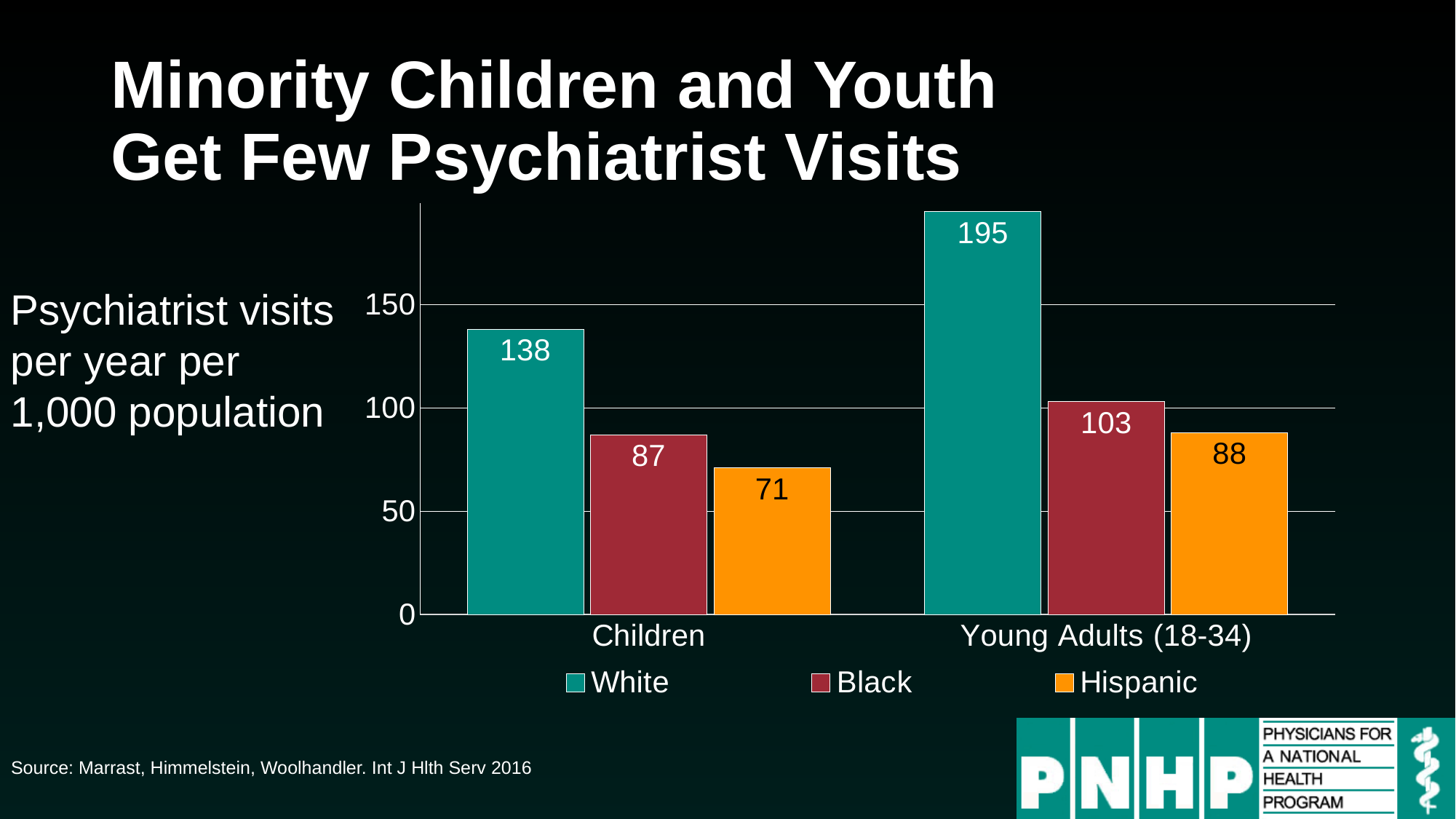
What is the difference between the White values for Young Adults (18-34) and Children? 57 Which series has the highest value in the Young Adults (18-34) category? White What is the value for Black in the Children category? 87 How many series does the legend list? 3 Is the value for Black in the Young Adults (18-34) category greater or less than 100? greater What is the difference between the White and Black values for Young Adults (18-34)? 92 Which series has the lowest value in the Children category? Hispanic What kind of chart is shown on the slide? bar chart What is the value for White in the Children category? 138 How many categories are shown on the x axis? 2 Which is larger, the Black value for Children or the Hispanic value for Young Adults (18-34)? Hispanic value for Young Adults (18-34) What is the value for Hispanic in the Young Adults (18-34) category? 88